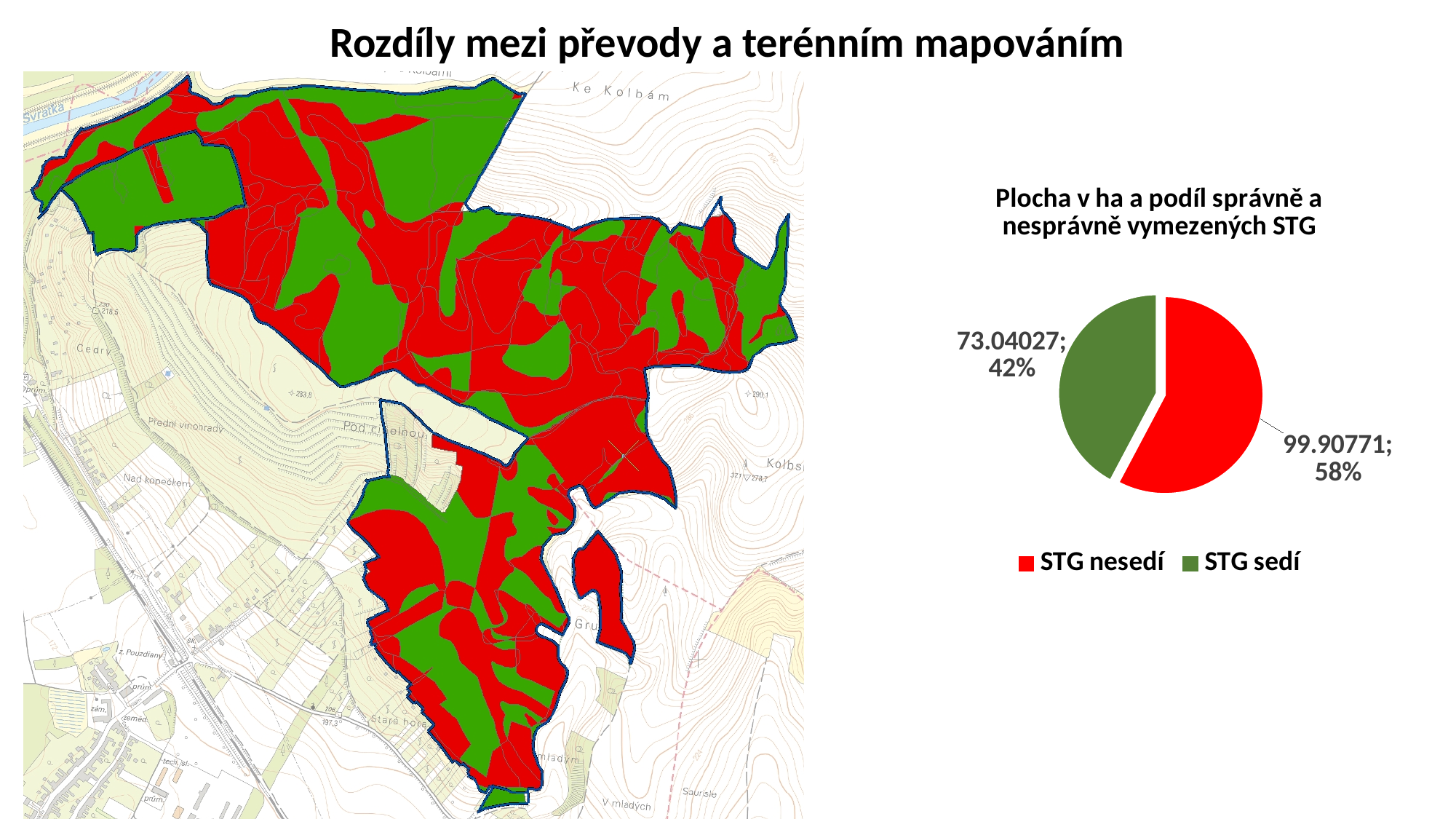
How many slices does the pie chart have? 2 What share of the pie does STG sedí represent? 42% What share of the pie does STG nesedí represent? 58% How many series does the legend of the pie chart list? 2 What is the title of the pie chart? Plocha v ha a podíl správně a nesprávně vymezených STG What kind of chart is shown on the slide? pie chart Which category has the largest slice in the pie chart? STG nesedí What colour represents STG sedí in the pie chart? green Which category has the smallest slice in the pie chart? STG sedí What is the area value (in ha) for STG sedí? 73.04027 Which is larger, the value for STG nesedí or STG sedí? STG nesedí What is the area value (in ha) for STG nesedí? 99.90771